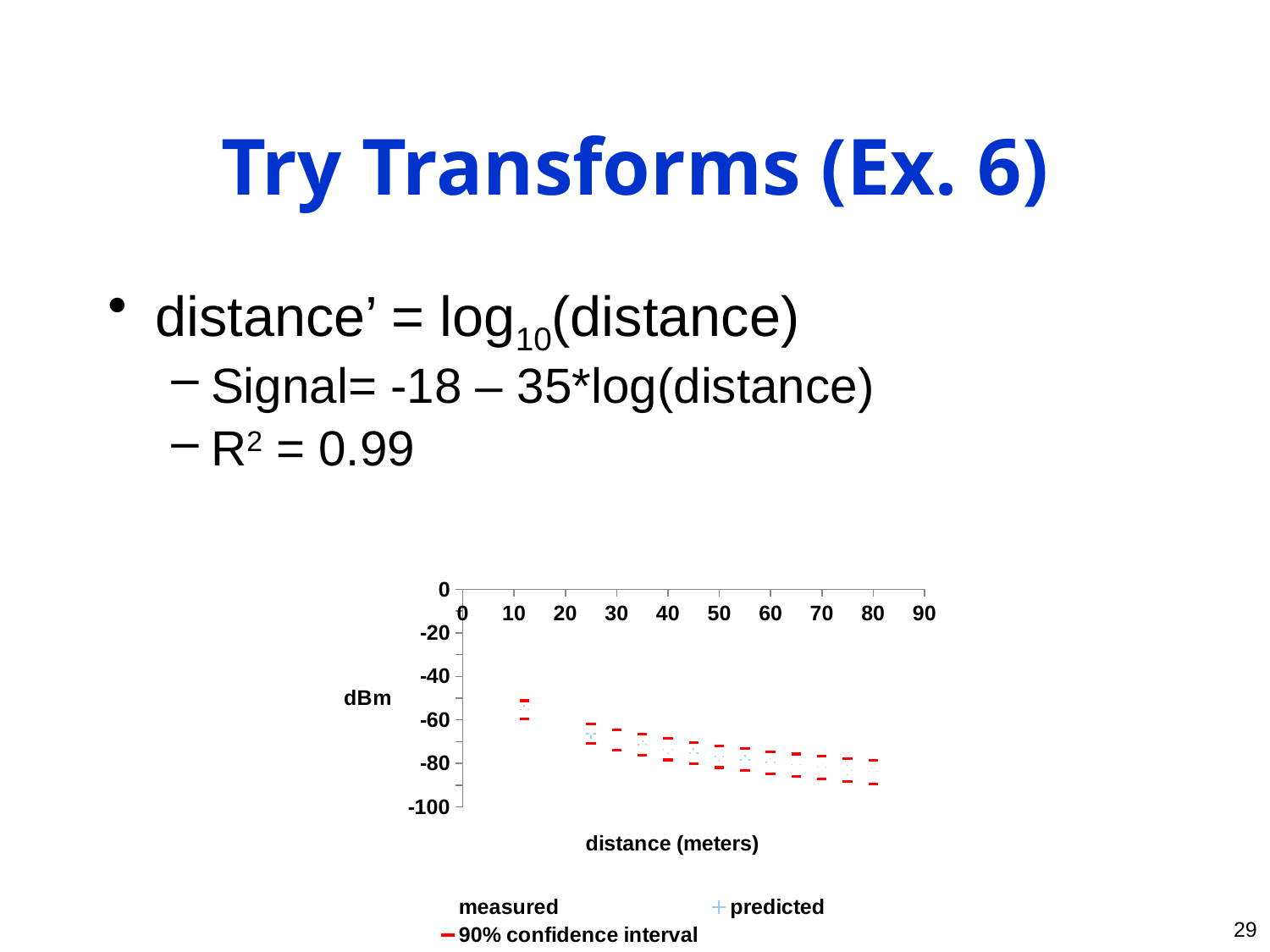
Which has the higher dBm value: the point at the smallest plotted distance or the point at the largest plotted distance? the point at the smallest plotted distance How many series does the chart's legend list? 3 Is the measured dBm value at the smallest plotted distance (around 12 meters) greater or less than -40? less What is the highest value shown on the x axis of the chart? 90 What is the title of the x axis of the chart? distance (meters) Is the measured dBm value at the largest plotted distance (around 80 meters) greater or less than -60? less What kind of chart is shown on the slide? scatter chart Is the measured dBm value at the smallest plotted distance (around 12 meters) greater or less than -80? greater Do the plotted dBm values rise or fall as distance increases along the x axis? fall What is the label on the y axis of the chart? dBm